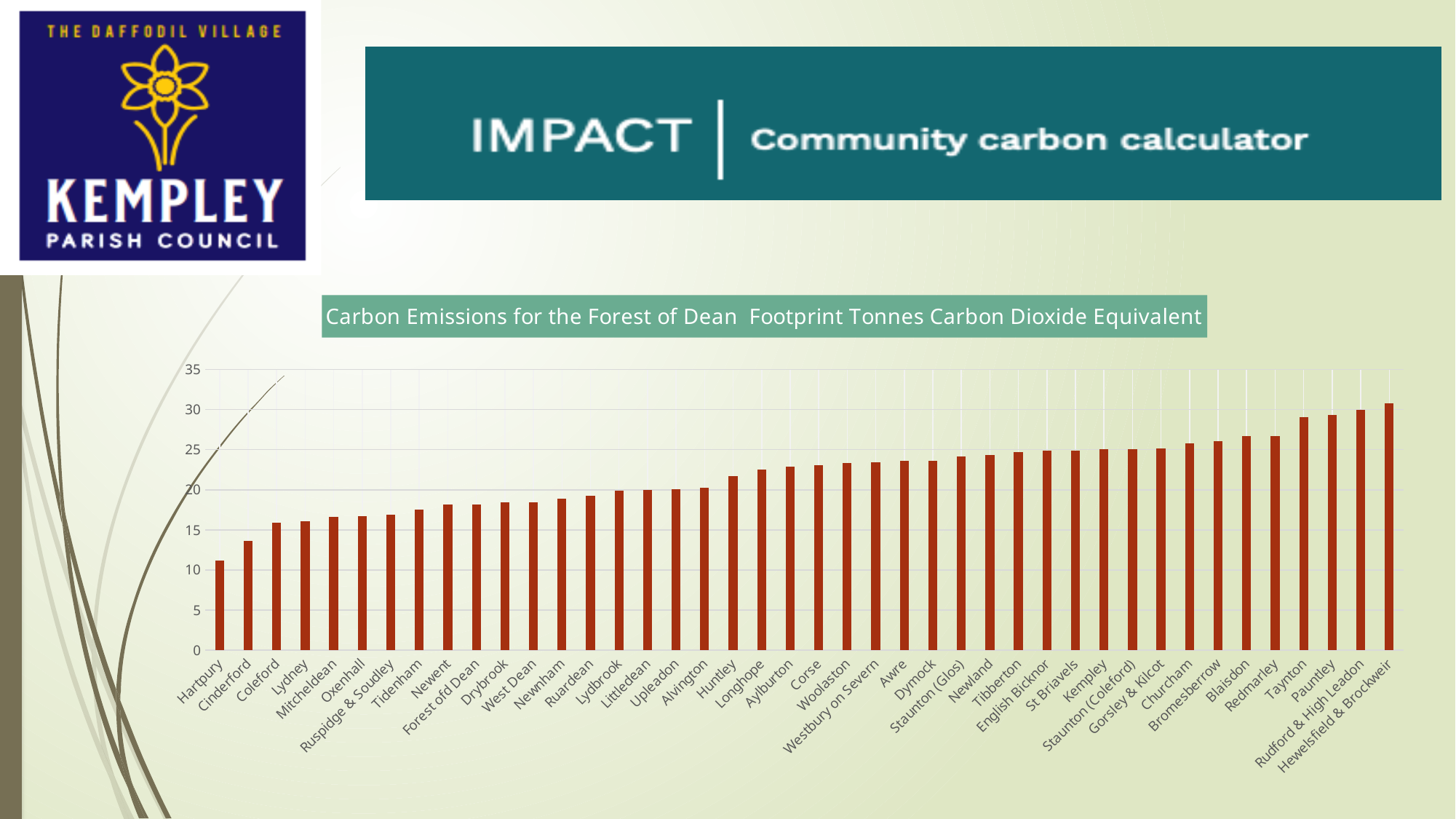
Is the value for Hewelsfield & Brockweir greater or less than 25? greater Which has the larger value, Cinderford or Huntley? Huntley Which has the larger value, Hartpury or Taynton? Taynton What kind of chart is shown on the slide? bar chart Is the value for Huntley greater or less than 20? greater Do the values rise or fall moving from left to right along the x axis? rise Is the value for Hartpury greater or less than 10? greater How many parishes are plotted in the chart? 42 Which parish has the highest carbon footprint in the chart? Hewelsfield & Brockweir Which parish has the lowest carbon footprint in the chart? Hartpury What is the title of the chart? Carbon Emissions for the Forest of Dean Footprint Tonnes Carbon Dioxide Equivalent